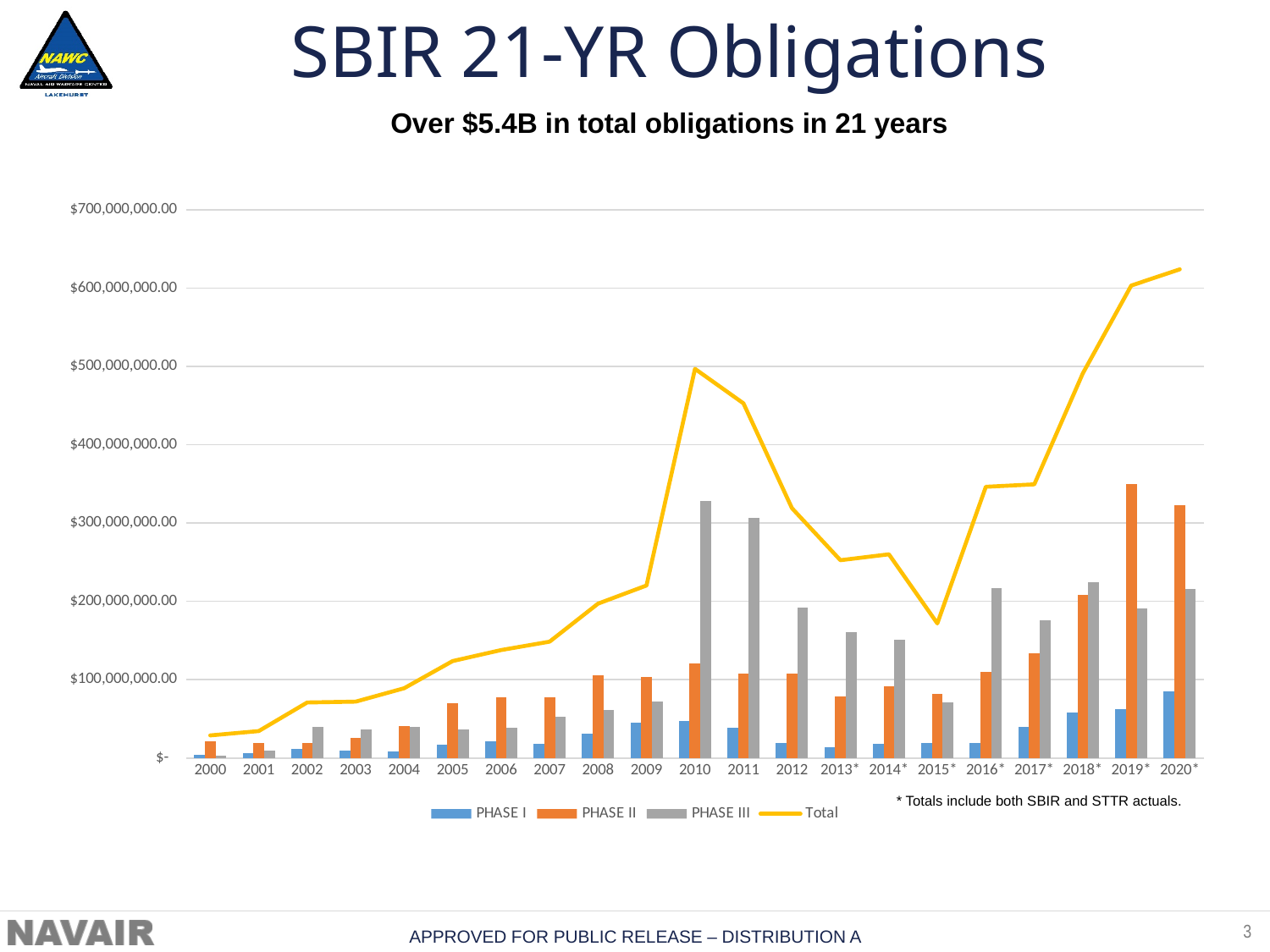
Is the Total value for 2015* greater or less than $200,000,000.00? less In 2019*, which is larger, PHASE II or PHASE III? PHASE II How many years are shown along the x axis of the chart? 21 How many series does the chart's legend list? 4 Is the PHASE III value for 2010 greater or less than $300,000,000.00? greater Is the Total value for 2010 greater or less than $400,000,000.00? greater What kind of chart is shown on the slide? A bar chart combined with a line chart In which year does the Total line reach its highest point? 2020* In which year is the PHASE III bar the tallest? 2010 In 2011, which is larger, PHASE II or PHASE III? PHASE III Does the Total line rise or fall from 2015* to 2020*? rise In which year is the Total line at its lowest point? 2000